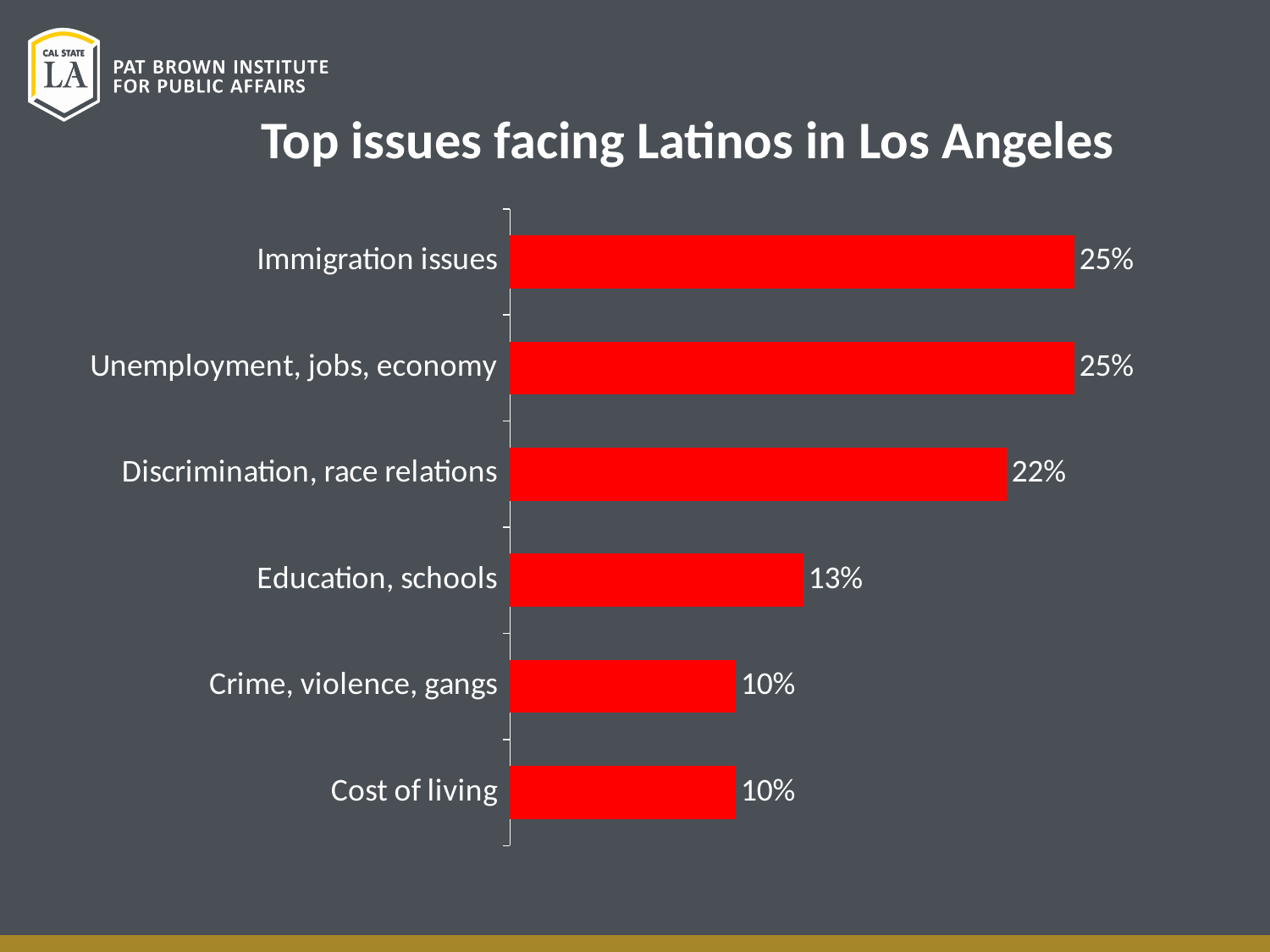
What is the title of the chart? Top issues facing Latinos in Los Angeles What colour are the bars in the chart? Red What is the difference in percentage points between Discrimination, race relations and Crime, violence, gangs? 12 What is the difference in percentage points between Immigration issues and Education, schools? 12 What kind of chart is shown on the slide? Bar chart Which is larger, the value for Unemployment, jobs, economy or the value for Discrimination, race relations? Unemployment, jobs, economy Which issue has the lowest percentage among those with a unique value, Education, schools or Discrimination, race relations? Education, schools How many issues are listed in the chart? 6 What percentage is shown for Discrimination, race relations? 22% What percentage is shown for Education, schools? 13% What percentage is shown for Cost of living? 10% What percentage is shown for Immigration issues? 25%